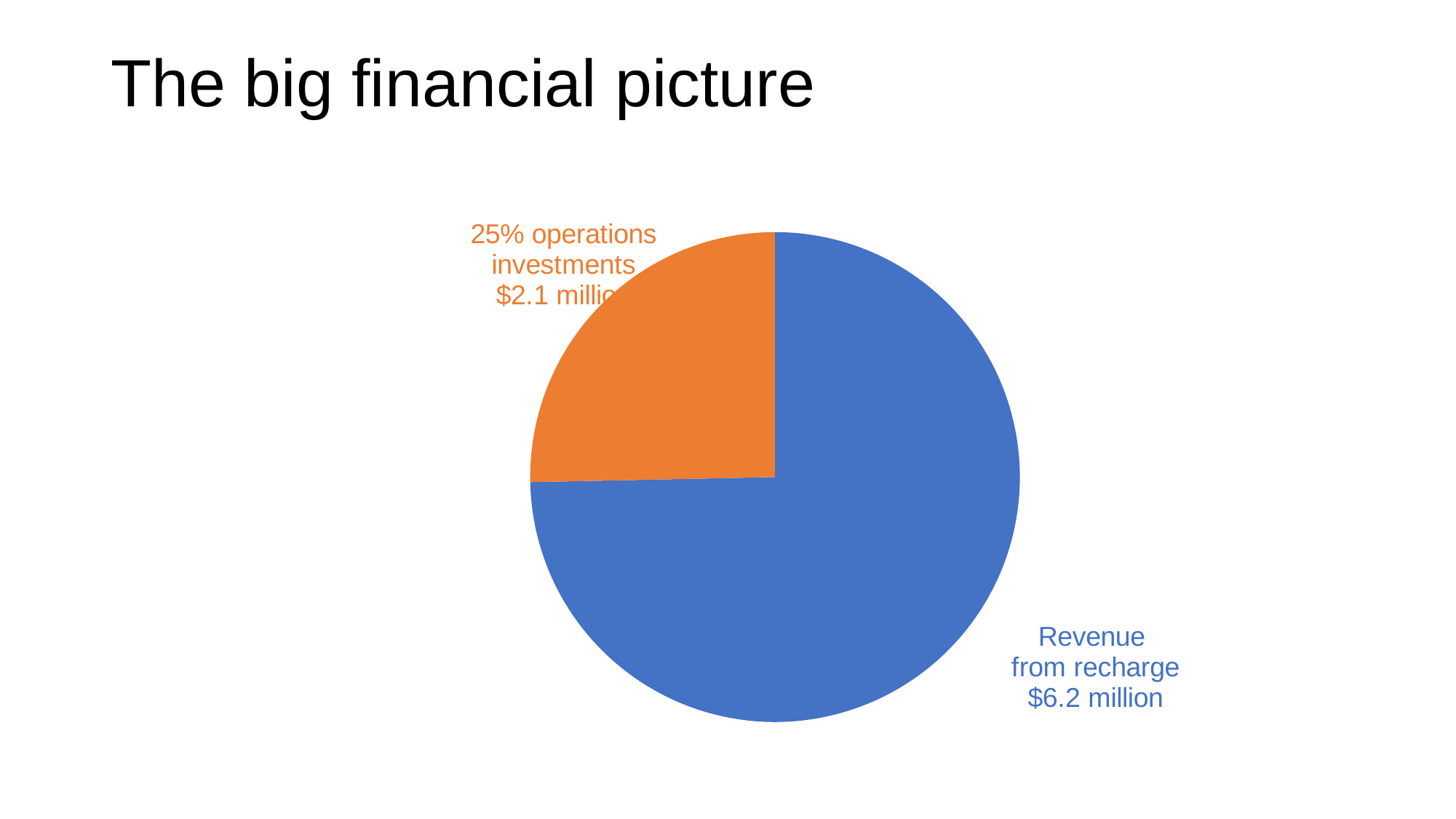
Which is larger, revenue from recharge or operations investments? Revenue from recharge What share of the pie do operations investments represent? 25% What kind of chart is shown on the slide? pie chart How many slices does the pie chart have? 2 What is the value shown for revenue from recharge? $6.2 million Which slice of the pie is the largest? Revenue from recharge What is the difference between revenue from recharge and operations investments? $4.1 million What colour is the revenue from recharge slice? blue What is the title of the slide containing the pie chart? The big financial picture What is the value shown for operations investments? $2.1 million Which slice of the pie is the smallest? Operations investments